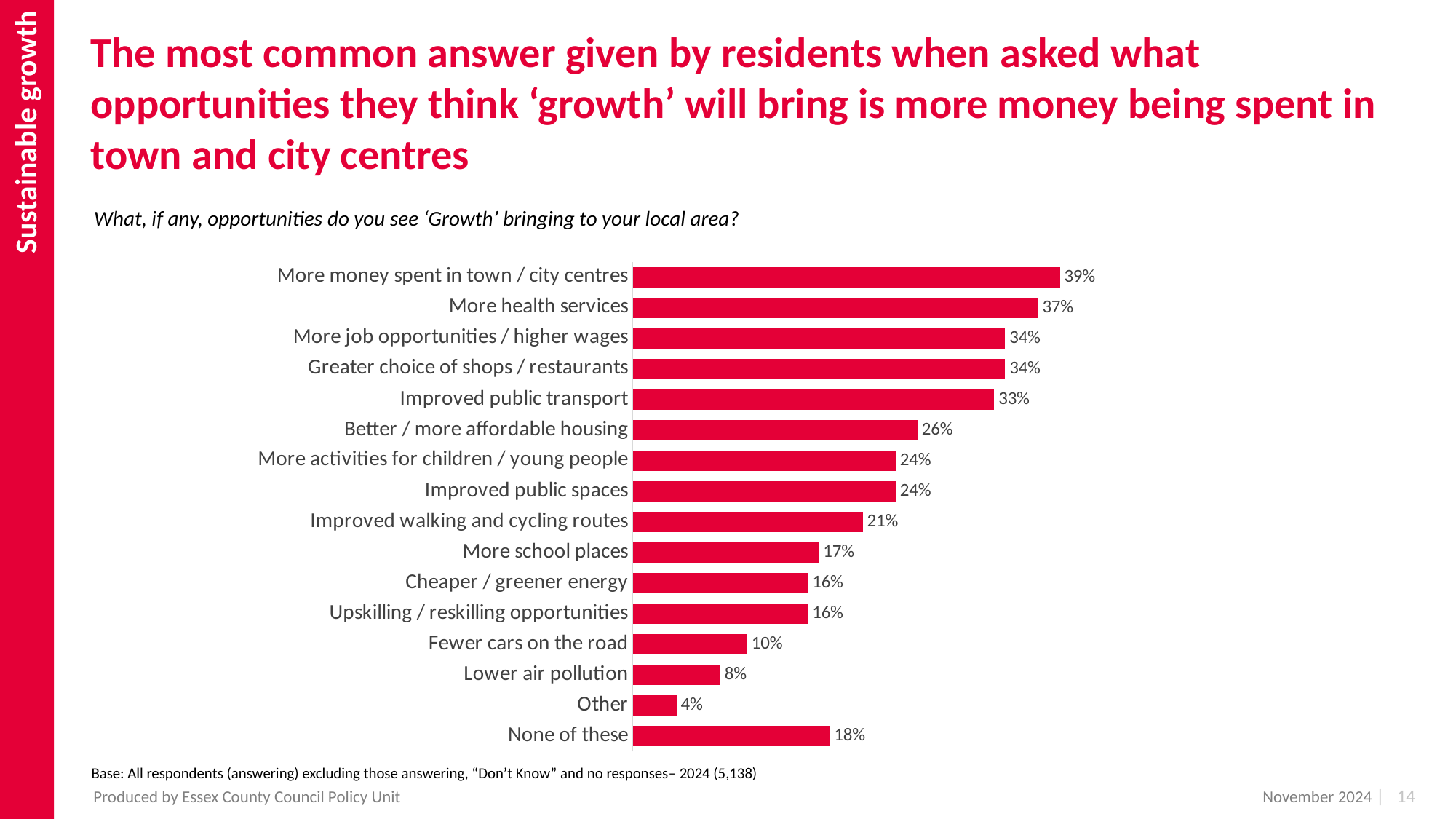
What percentage is shown for 'None of these'? 18% What is the difference between the values for 'Lower air pollution' and 'Other'? 4 percentage points What is the difference between the values for 'More money spent in town / city centres' and 'Better / more affordable housing'? 13 percentage points What is the value shown for 'Improved public transport'? 33% How many categories are shown in the chart? 16 What survey question is the chart based on, as shown above the chart? What, if any, opportunities do you see 'Growth' bringing to your local area? Which category has the highest value in the chart? More money spent in town / city centres Which category has the lowest value in the chart? Other What value is shown for 'Improved walking and cycling routes'? 21% What percentage of respondents selected 'More health services'? 37% What kind of chart is shown on the slide? Bar chart Which has a larger value: 'More school places' or 'Fewer cars on the road'? More school places